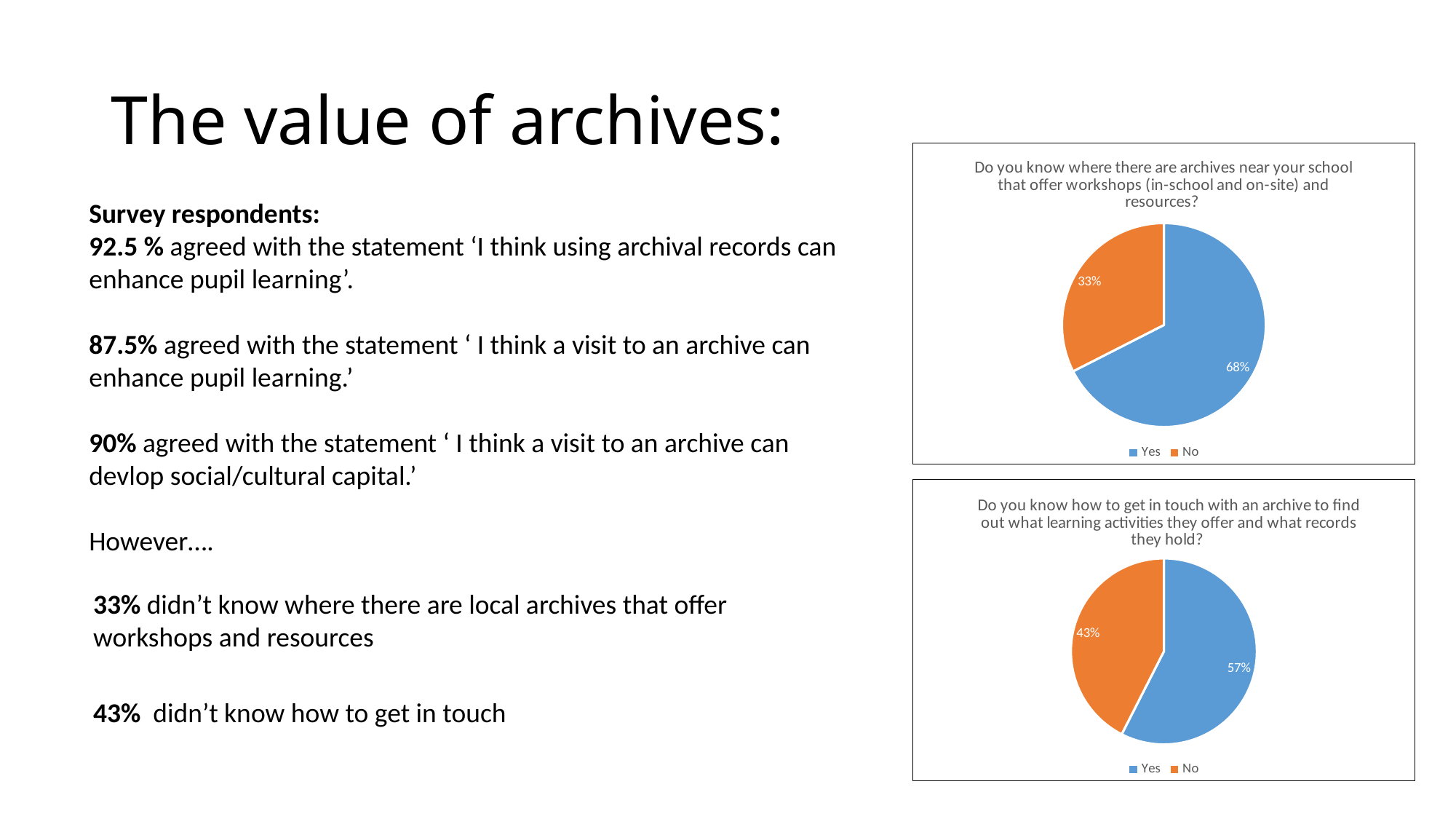
In the bottom pie chart, what colour is the No slice? Orange How many entries does the legend of the top pie chart list? 2 In the bottom pie chart, which answer has the smaller slice? No In the top pie chart, which answer has the larger slice, Yes or No? Yes In the bottom pie chart, what is the difference in percentage points between the Yes and No slices? 14 In the top pie chart, what is the difference in percentage points between the Yes and No slices? 35 In the top pie chart (about knowing where there are archives near your school), what share of respondents answered Yes? 68% How many slices does the bottom pie chart have? 2 In the bottom pie chart (about knowing how to get in touch with an archive), what share of respondents answered Yes? 57% In the bottom pie chart (about knowing how to get in touch with an archive), what share of respondents answered No? 43% In the top pie chart (about knowing where there are archives near your school), what share of respondents answered No? 33% What type of chart is the top chart on the slide? Pie chart